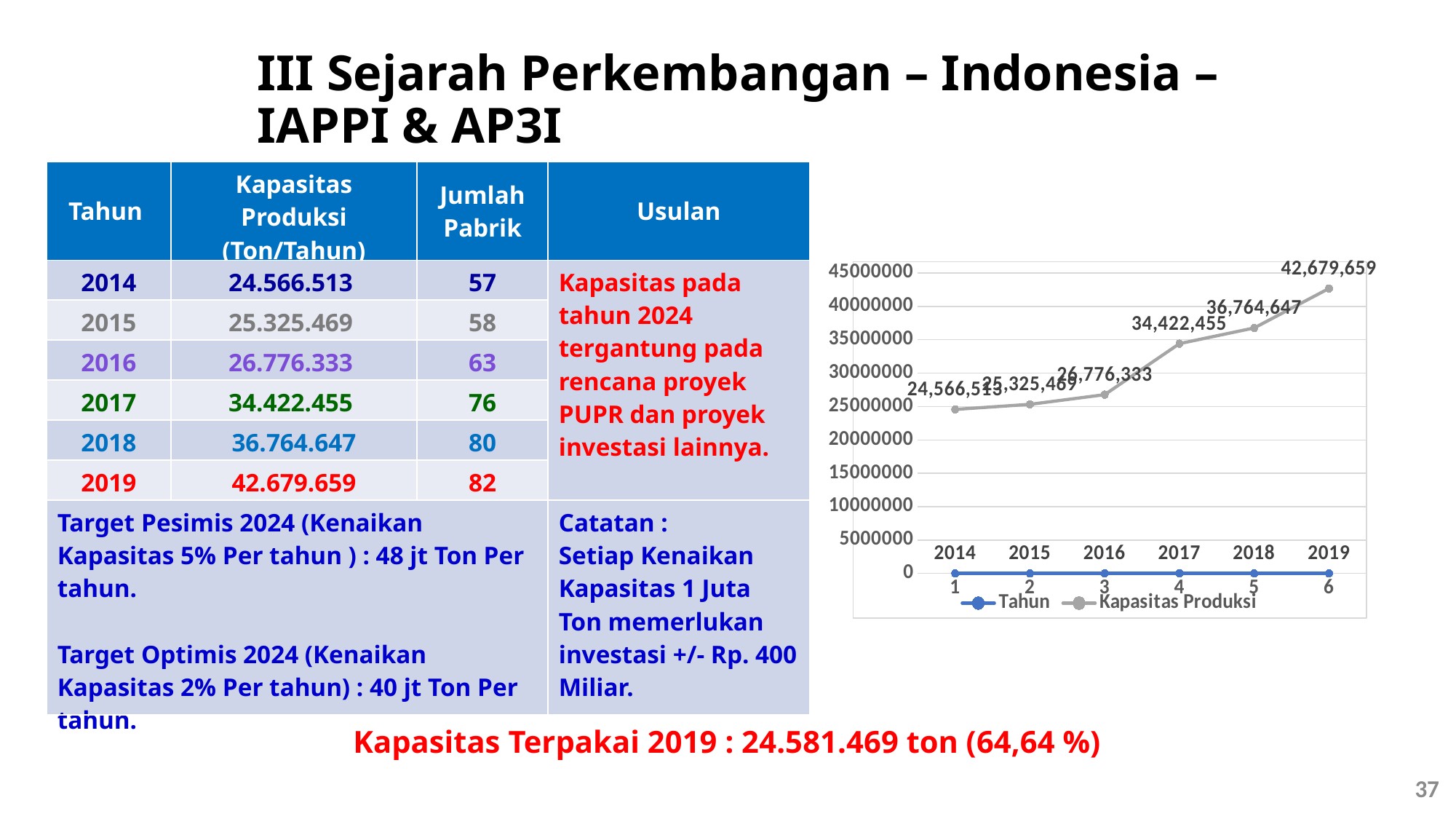
What is the Kapasitas Produksi value labelled for 2019 in the chart? 42,679,659 What type of chart is shown on the right side of the slide? line chart Which year has the highest Kapasitas Produksi value in the chart? 2019 What is the Kapasitas Produksi value labelled for 2017 in the chart? 34,422,455 Which year has the lowest Kapasitas Produksi value in the chart? 2014 What is the difference between the Kapasitas Produksi values for 2019 and 2018 in the chart? 5,915,012 How many data points does the Kapasitas Produksi line have? 6 Does the Kapasitas Produksi line rise or fall from 2014 to 2019? rise What are the two series named in the chart legend? Tahun and Kapasitas Produksi What is the Kapasitas Produksi value labelled for 2016 in the chart? 26,776,333 Is the Kapasitas Produksi value for 2017 greater or less than 30000000? greater How many series does the chart legend list? 2